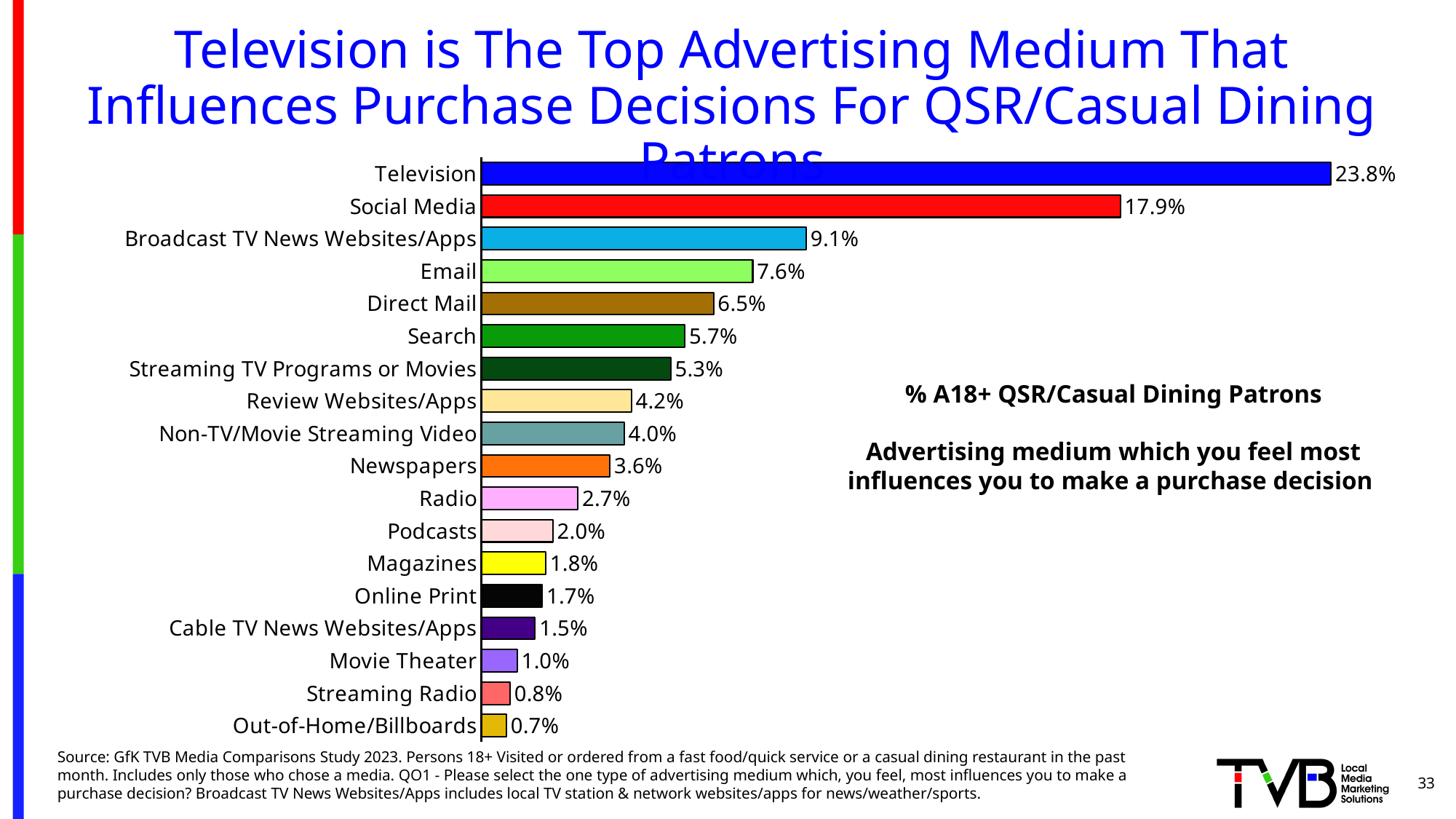
Which advertising medium has the lowest value? Out-of-Home/Billboards What is the value for Television? 23.8% Which has a larger value, Newspapers or Radio? Newspapers What is the value for Out-of-Home/Billboards? 0.7% What colour is the bar for Social Media? Red What is the difference between the values for Television and Social Media? 5.9% What is the difference between the values for Email and Direct Mail? 1.1% What is the value for Social Media? 17.9% What is the value for Streaming TV Programs or Movies? 5.3% What kind of chart is shown on the slide? Bar chart How many advertising media are shown in the chart? 18 Which advertising medium has the highest value? Television